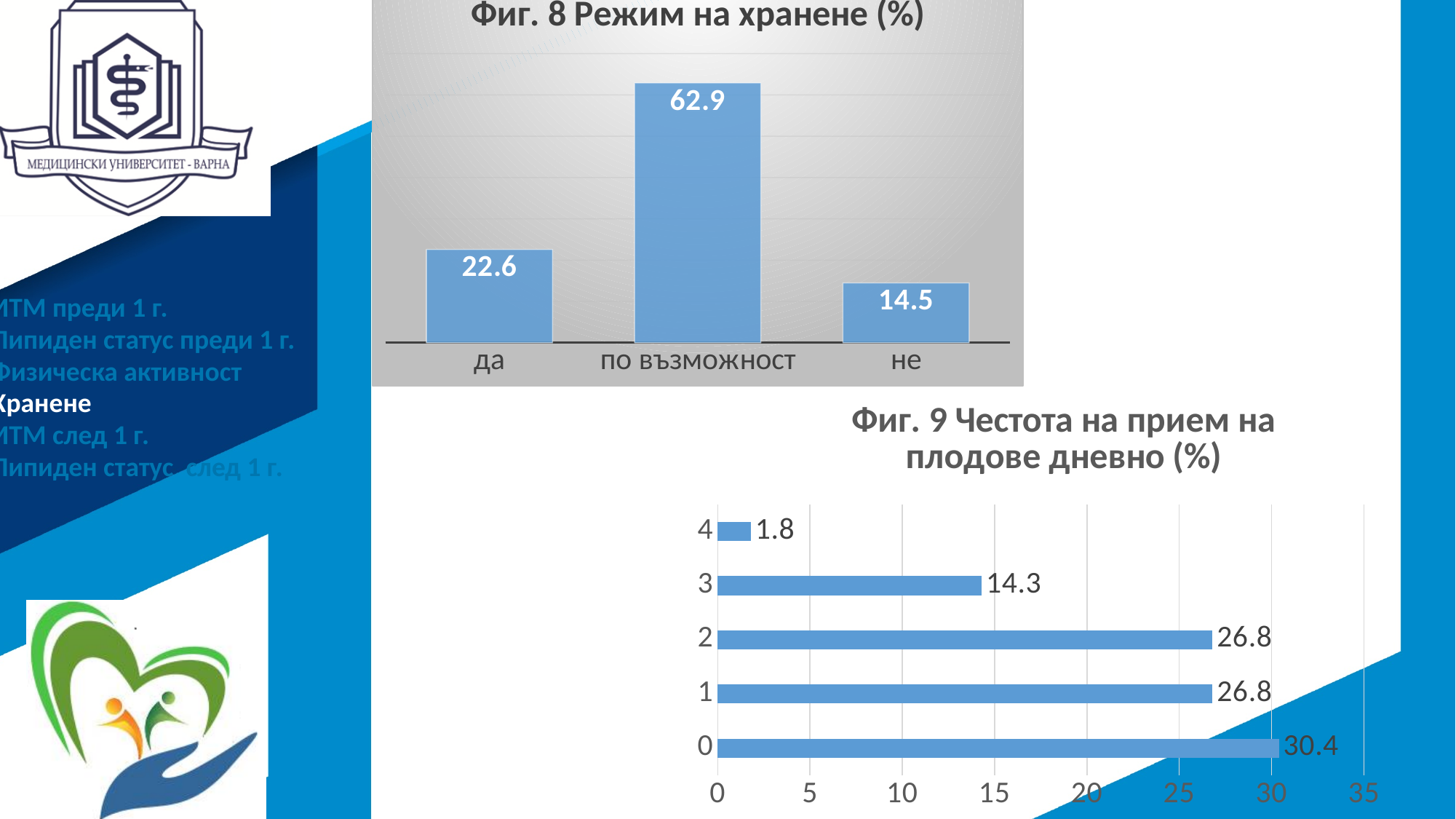
In the chart 'Фиг. 9 Честота на прием на плодове дневно (%)', what is the value for category '0'? 30.4 In the chart 'Фиг. 9 Честота на прием на плодове дневно (%)', is the value for category '3' greater or less than 15? less In the chart 'Фиг. 8 Режим на хранене (%)', what is the value for 'не'? 14.5 In the chart 'Фиг. 8 Режим на хранене (%)', what is the value for 'по възможност'? 62.9 In the chart 'Фиг. 9 Честота на прием на плодове дневно (%)', what is the difference between the values for category '0' and category '2'? 3.6 In the chart 'Фиг. 8 Режим на хранене (%)', what is the difference between the values for 'да' and 'не'? 8.1 In the chart 'Фиг. 8 Режим на хранене (%)', which category has the highest value? по възможност What kind of chart is 'Фиг. 9 Честота на прием на плодове дневно (%)'? bar chart In the chart 'Фиг. 8 Режим на хранене (%)', how many categories are shown? 3 In the chart 'Фиг. 8 Режим на хранене (%)', which category has the lowest value? не In the chart 'Фиг. 9 Честота на прием на плодове дневно (%)', what is the value for category '3'? 14.3 In the chart 'Фиг. 9 Честота на прием на плодове дневно (%)', which category has the lowest value? 4